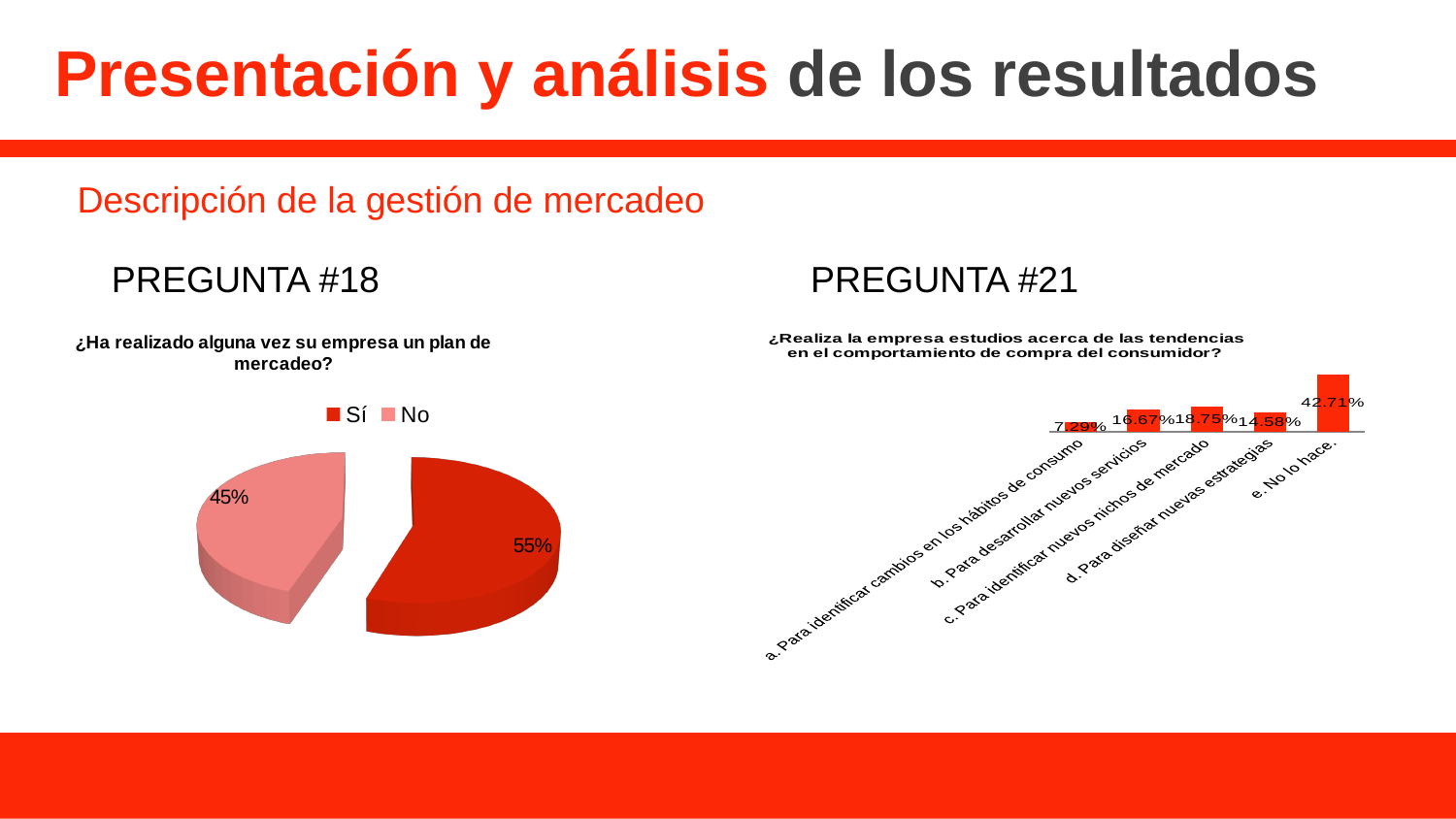
How many entries does the legend of the Pregunta #18 chart list? 2 In the Pregunta #21 chart, what is the value for 'e. No lo hace.'? 42.71% In the Pregunta #21 chart, which category has the lowest value? a. Para identificar cambios en los hábitos de consumo In the Pregunta #18 pie chart, what is the difference in percentage points between Sí and No? 10 What type of chart is used for Pregunta #18? Pie chart In the Pregunta #18 pie chart, which answer has the larger share, Sí or No? Sí In the Pregunta #21 chart, what is the difference between 'c. Para identificar nuevos nichos de mercado' and 'b. Para desarrollar nuevos servicios'? 2.08% In the Pregunta #18 pie chart, what percentage of respondents answered No? 45% In the Pregunta #21 chart, which category has the highest value? e. No lo hace. How many categories are shown in the Pregunta #21 chart? 5 In the Pregunta #18 pie chart, what percentage of respondents answered Sí? 55% In the Pregunta #21 chart, what is the value for 'a. Para identificar cambios en los hábitos de consumo'? 7.29%